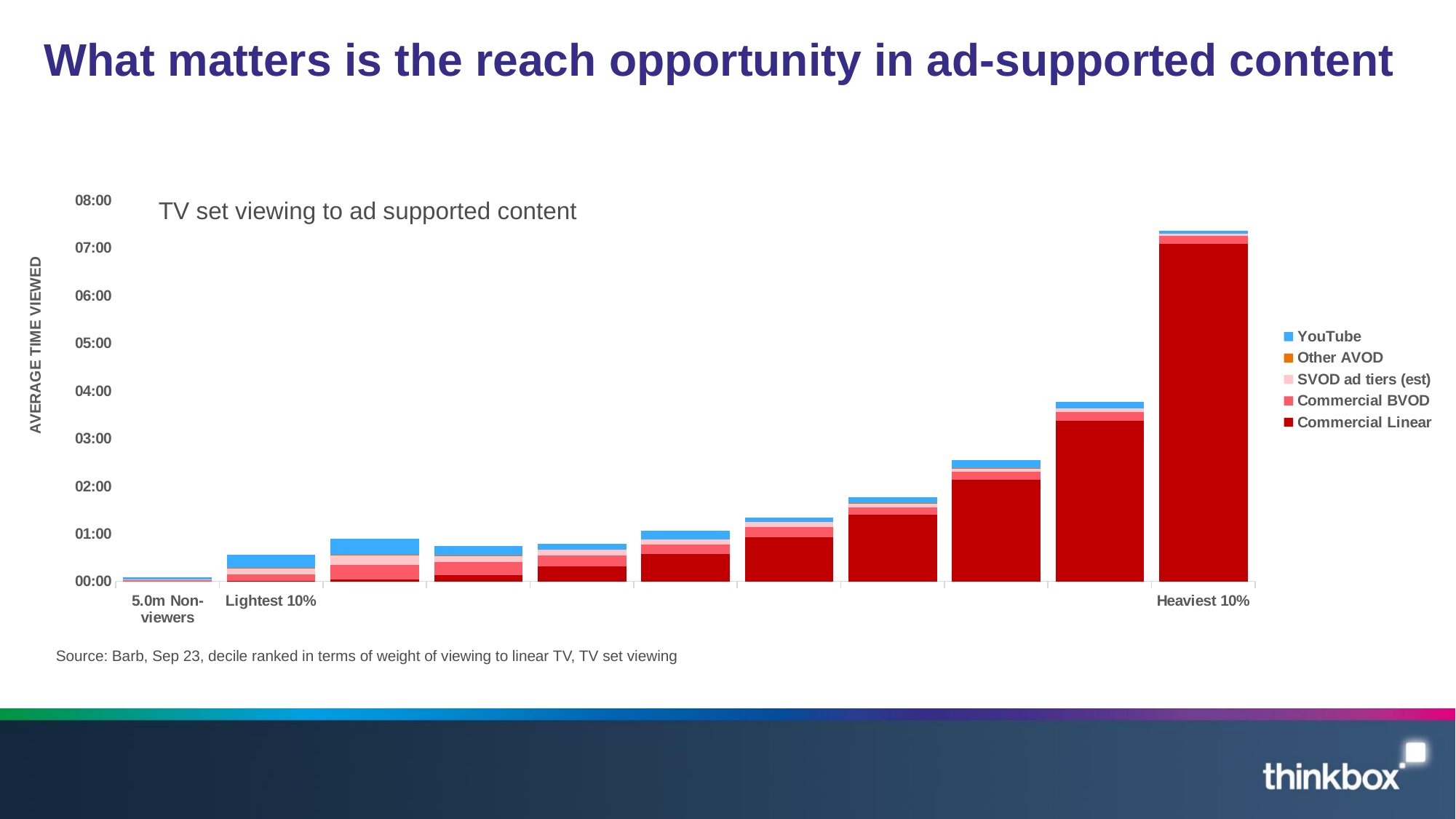
Which has a larger total average time viewed, Lightest 10% or Heaviest 10%? Heaviest 10% Do the bar totals generally rise or fall moving from left to right along the x axis? Rise Which category has the highest total average time viewed? Heaviest 10% What kind of chart is shown on the slide? Stacked bar chart How many bars are plotted in the chart? 11 What is the title of the chart? TV set viewing to ad supported content Is the total value for Heaviest 10% greater or less than 07:00? greater Which category has the lowest total average time viewed? 5.0m Non-viewers How many series does the legend list? 5 What is the label on the vertical axis? AVERAGE TIME VIEWED Is the total value for 5.0m Non-viewers greater or less than 01:00? less Is the total value for Lightest 10% greater or less than 01:00? less